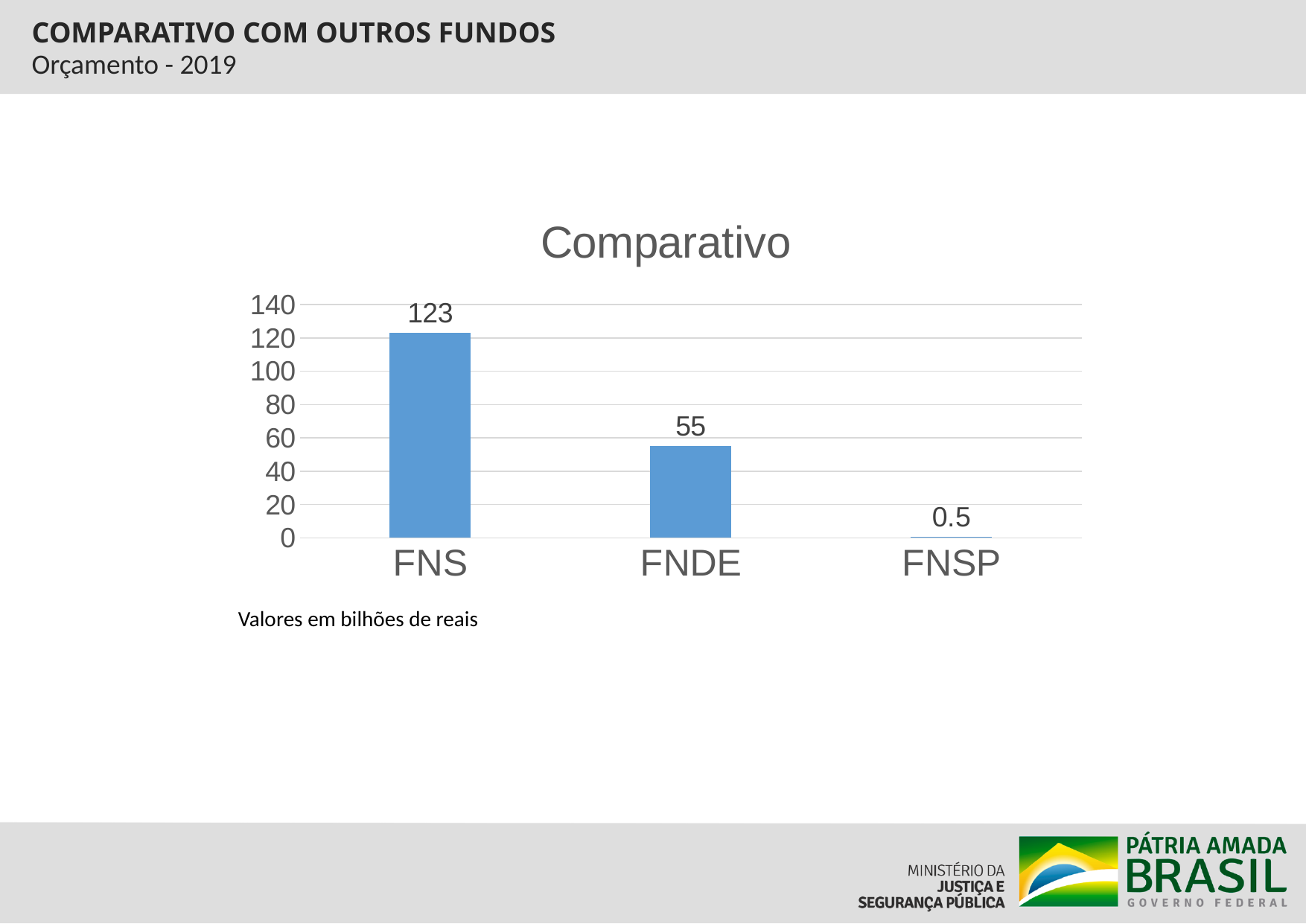
Which category has the lowest value? FNSP What is the difference between the values for FNDE and FNSP? 54.5 Which category has the highest value? FNS How many categories are shown on the chart? 3 Is the value for FNS greater or less than 100? greater What kind of chart is shown on the slide? bar chart What is the value for FNDE? 55 What is the value for FNSP? 0.5 Which is larger, the value for FNDE or the value for FNSP? FNDE What is the title of the chart? Comparativo What is the value for FNS? 123 What is the difference between the values for FNS and FNDE? 68